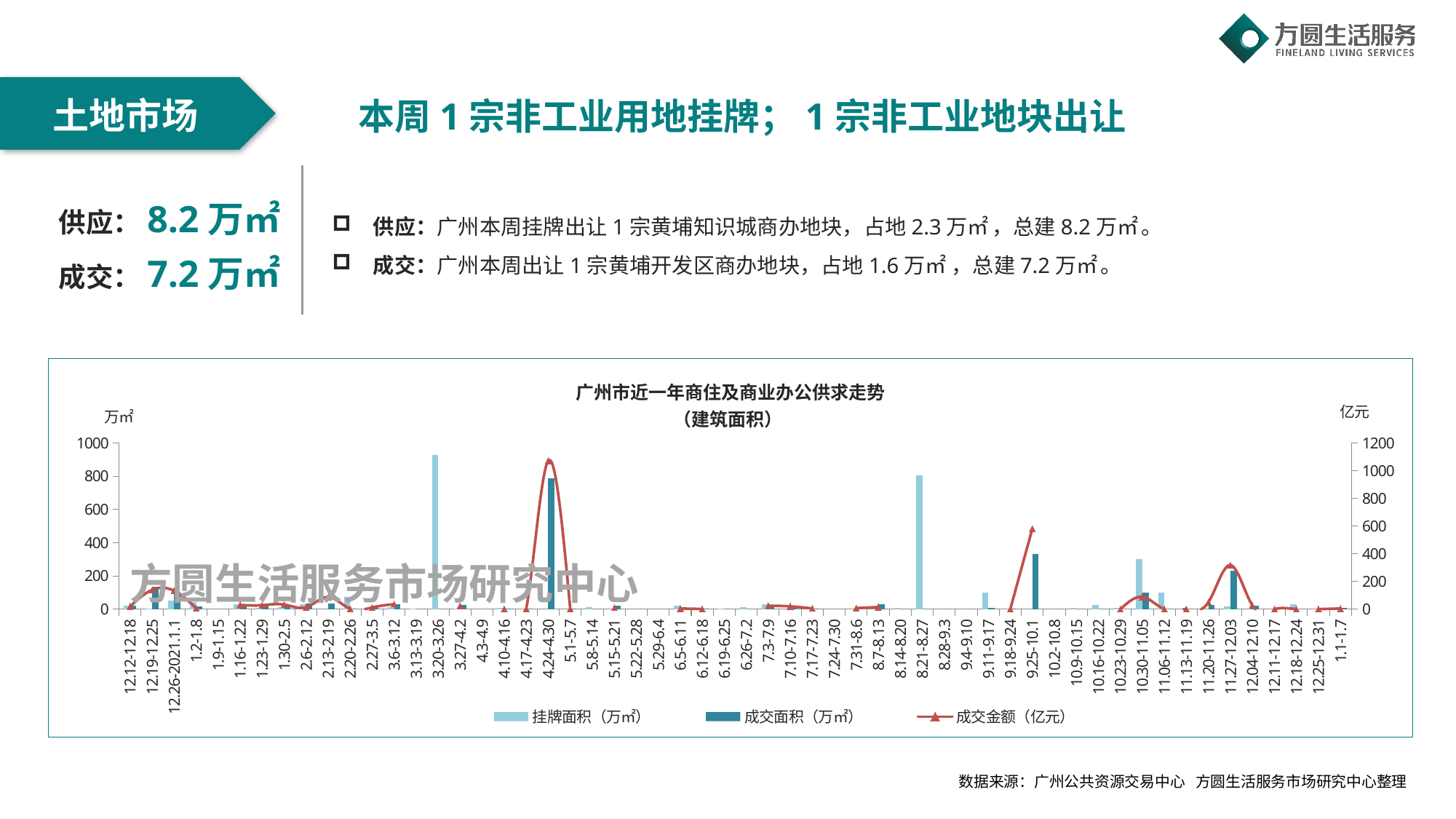
Is the 挂牌面积 value for 3.20-3.26 greater or less than 800? greater What kind of chart is shown on the slide? Combined bar and line chart Is the 成交金额 value for 9.25-10.1 greater or less than 400 亿元? greater In which week does 挂牌面积 reach its highest value? 3.20-3.26 Which series in the chart is drawn as a line with triangle markers? 成交金额（亿元） Which week has the larger 成交面积, 4.24-4.30 or 9.25-10.1? 4.24-4.30 What is the title of the chart on the slide? 广州市近一年商住及商业办公供求走势（建筑面积） Which week has the larger 挂牌面积, 3.20-3.26 or 8.21-8.27? 3.20-3.26 Is the 成交面积 value for 9.25-10.1 greater or less than 200? greater How many series does the chart legend list? 3 In which week does 成交金额 reach its highest value? 4.24-4.30 In which week does 成交面积 reach its highest value? 4.24-4.30